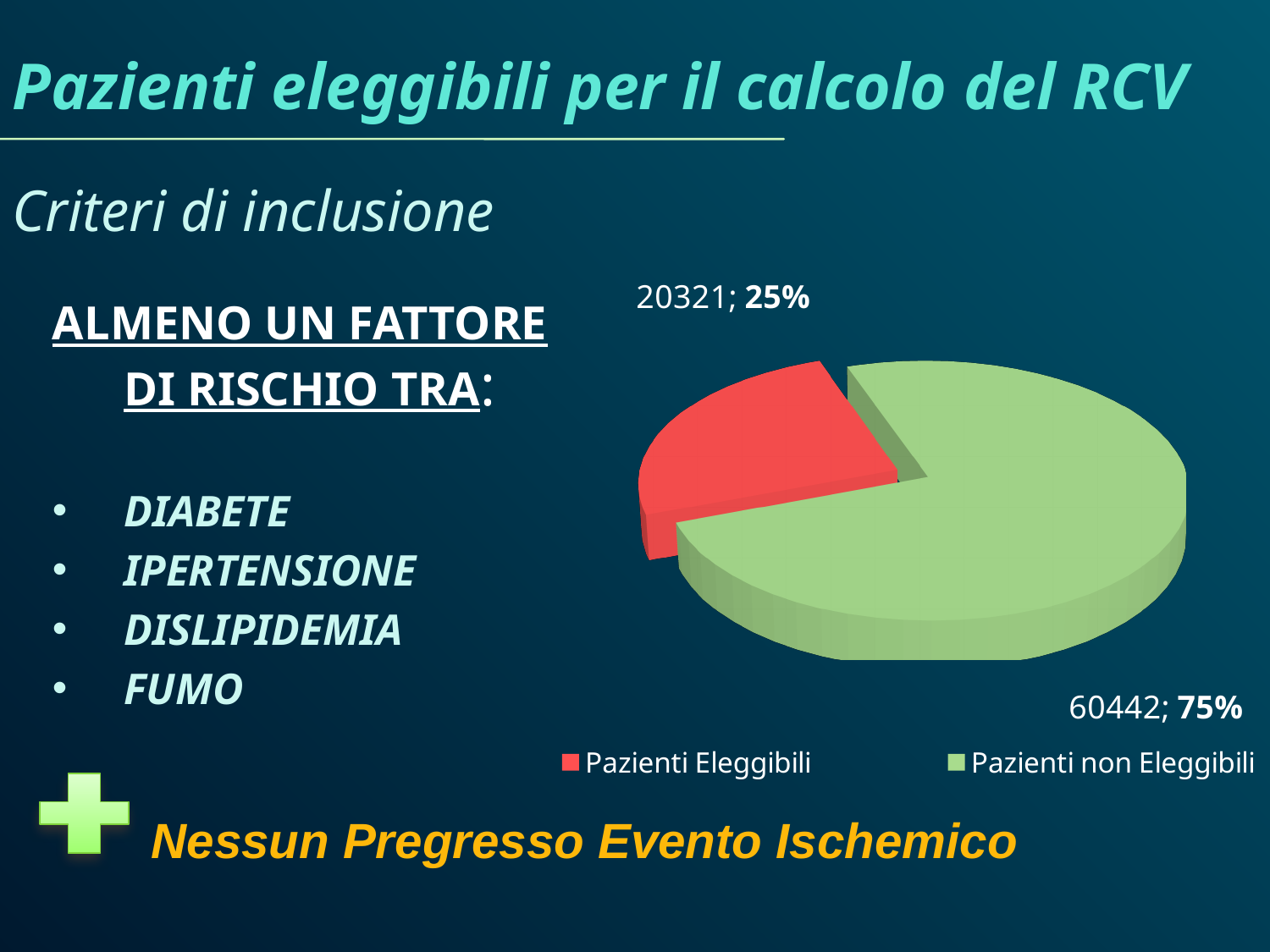
What is the difference between the values for Pazienti non Eleggibili and Pazienti Eleggibili? 40121 What is the value for Pazienti non Eleggibili? 60442 What kind of chart is shown on the slide? pie chart Which is larger, Pazienti Eleggibili or Pazienti non Eleggibili? Pazienti non Eleggibili How many entries does the legend of the pie chart list? 2 What share of the pie does Pazienti Eleggibili represent? 25% Which slice is the smallest in the pie chart? Pazienti Eleggibili Which slice is the largest in the pie chart? Pazienti non Eleggibili How many slices does the pie chart have? 2 What share of the pie does Pazienti non Eleggibili represent? 75% What colour is the Pazienti Eleggibili slice in the pie chart? red What is the value for Pazienti Eleggibili? 20321